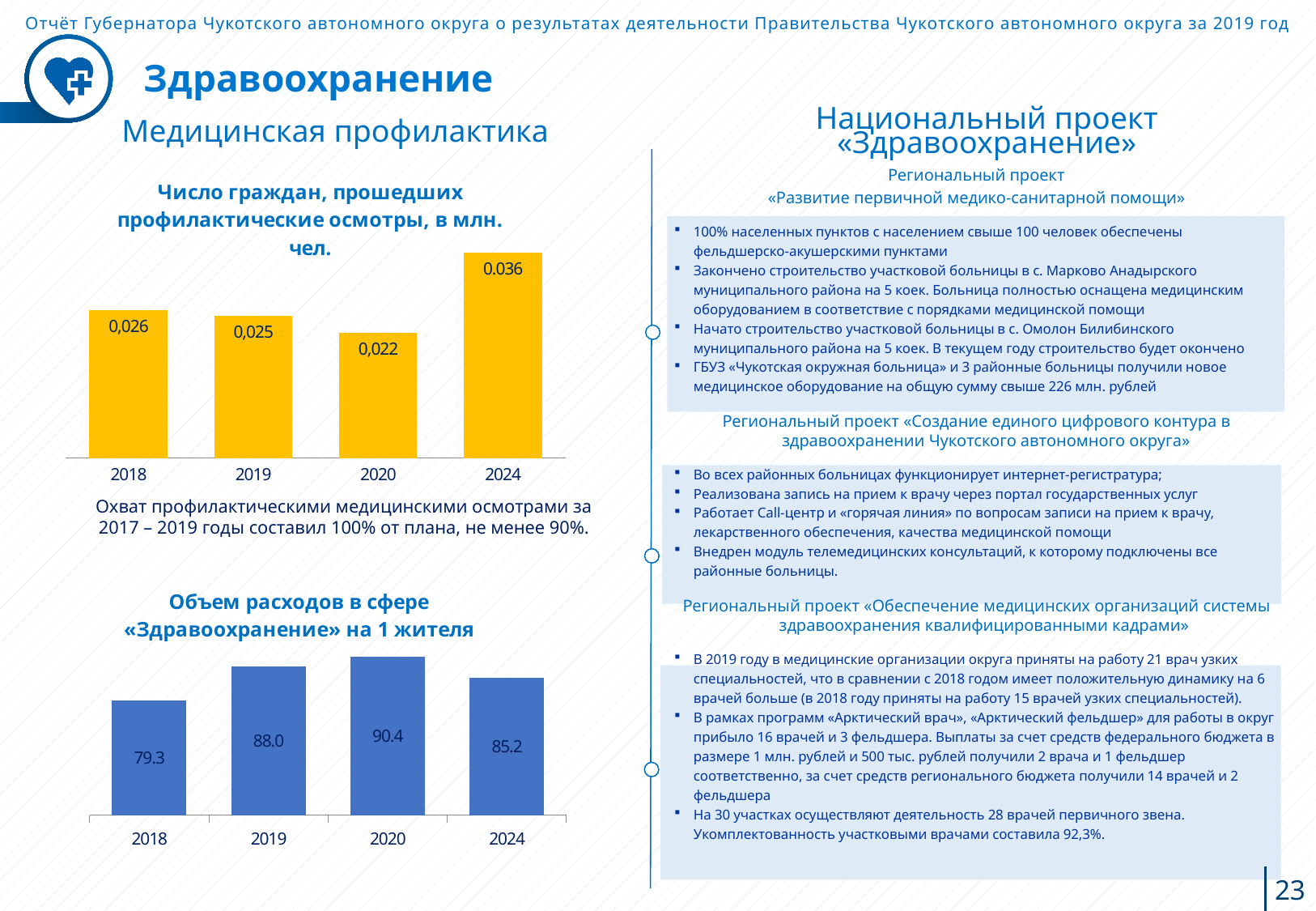
In the chart 'Число граждан, прошедших профилактические осмотры, в млн. чел.', which year has the lowest value? 2020 In the chart 'Объем расходов в сфере «Здравоохранение» на 1 жителя', which is larger, the value for 2019 or the value for 2024? 2019 In the chart 'Объем расходов в сфере «Здравоохранение» на 1 жителя', what is the value for 2019? 88.0 In the chart 'Число граждан, прошедших профилактические осмотры, в млн. чел.', which year has the highest value? 2024 What type of chart is 'Число граждан, прошедших профилактические осмотры, в млн. чел.'? Bar chart In the chart 'Число граждан, прошедших профилактические осмотры, в млн. чел.', what is the value for 2024? 0.036 In the chart 'Число граждан, прошедших профилактические осмотры, в млн. чел.', what is the value for 2018? 0,026 In the chart 'Число граждан, прошедших профилактические осмотры, в млн. чел.', how many years are shown on the x axis? 4 In the chart 'Объем расходов в сфере «Здравоохранение» на 1 жителя', what colour are the bars? Blue In the chart 'Объем расходов в сфере «Здравоохранение» на 1 жителя', what is the value for 2024? 85.2 In the chart 'Объем расходов в сфере «Здравоохранение» на 1 жителя', which year has the highest value? 2020 In the chart 'Объем расходов в сфере «Здравоохранение» на 1 жителя', what is the difference between the values for 2020 and 2018? 11.1